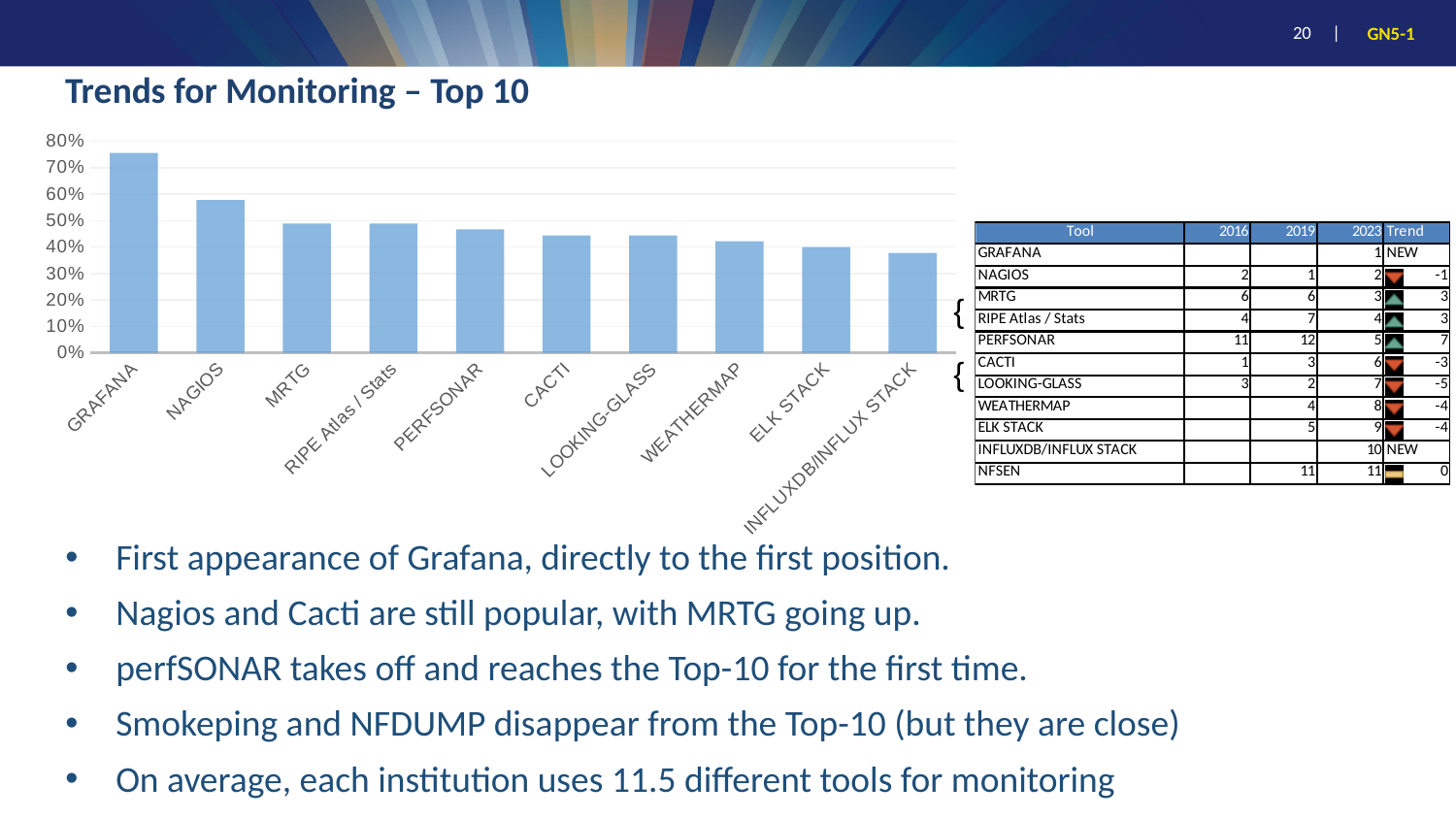
Is the value for WEATHERMAP greater or less than 50%? less Which tool has the lowest bar in the chart? INFLUXDB/INFLUX STACK Do the bar values rise or fall from left to right along the x axis? fall What kind of chart is shown on the slide? bar chart Is the value for GRAFANA greater or less than 70%? greater Is the value for NAGIOS greater or less than 50%? greater Which tool has the highest bar in the chart? GRAFANA What is the title of the slide containing the chart? Trends for Monitoring – Top 10 Which has a larger value, GRAFANA or NAGIOS? GRAFANA How many tools (categories) are plotted in the bar chart? 10